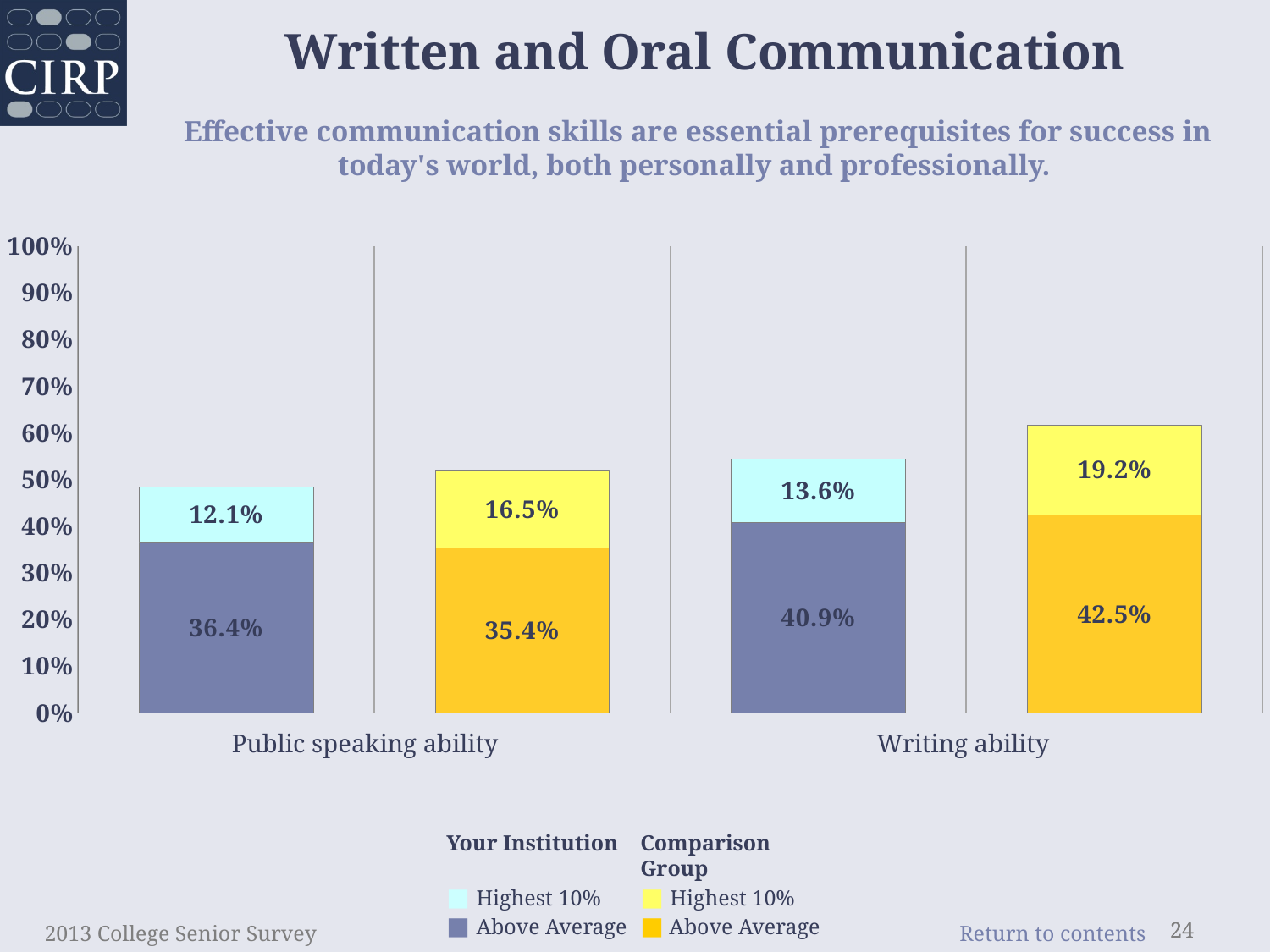
Which is larger for Writing ability Above Average: Your Institution or the Comparison Group? Comparison Group What is the total height of the Your Institution stacked bar for Public speaking ability? 48.5% What kind of chart is shown on the slide? Stacked bar chart What is the difference between the Comparison Group and Your Institution Highest 10% values for Public speaking ability? 4.4% What percentage of Your Institution students rated their writing ability in the Highest 10%? 13.6% What percentage of the Comparison Group rated their writing ability in the Highest 10%? 19.2% Which Highest 10% value is the lowest across all bars? 12.1% What is the total height of the Comparison Group stacked bar for Writing ability? 61.7% What percentage of Your Institution students rated their public speaking ability as Above Average? 36.4% How many series does the legend list? 4 Is the total of the Your Institution bar for Writing ability greater or less than 50%? greater Which Above Average value is the highest across all bars? 42.5%